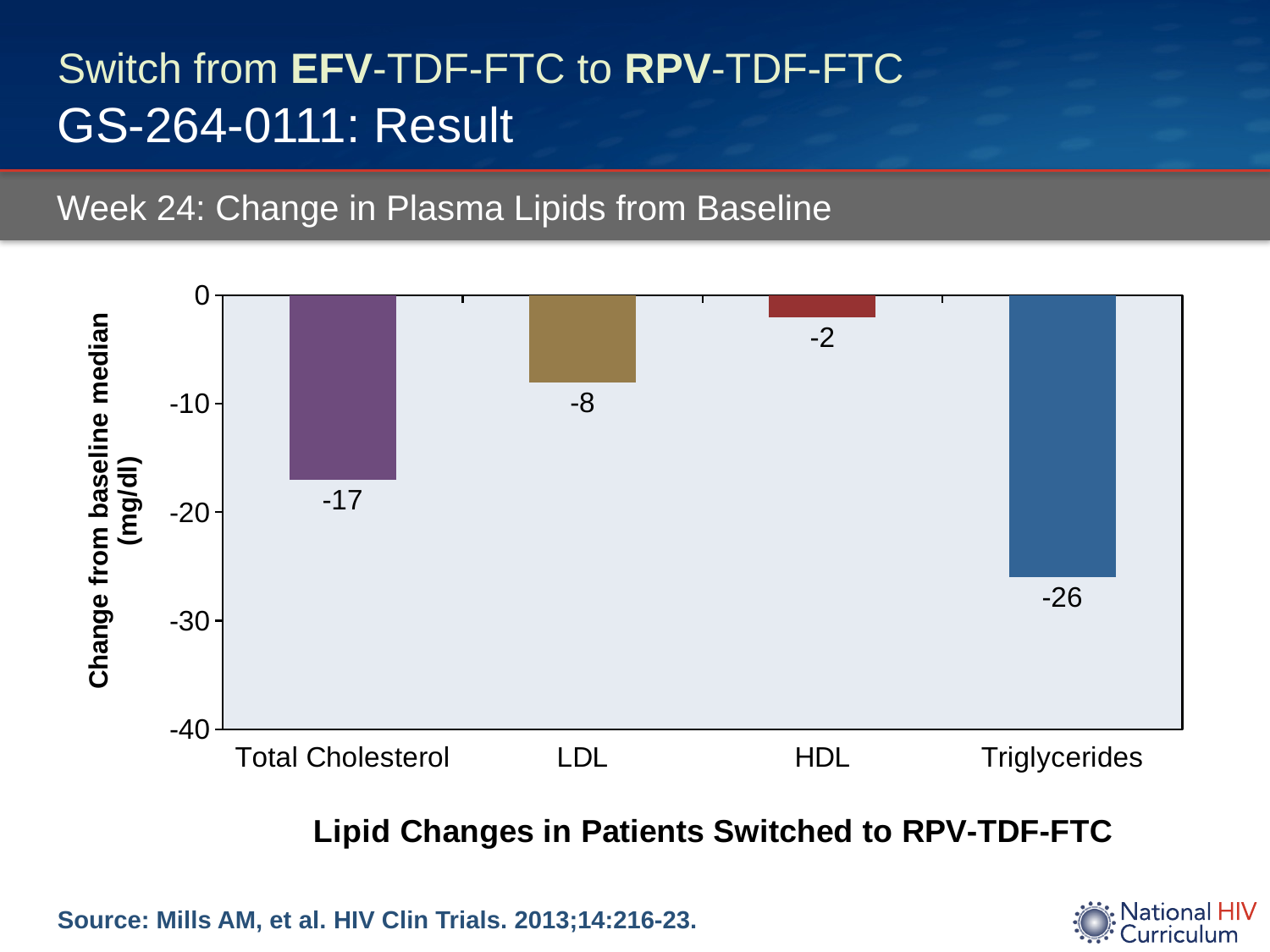
How many lipid categories are shown on the chart? 4 What kind of chart is shown on the slide? Bar chart What is the change from baseline median for LDL? -8 Which lipid category shows the largest decrease from baseline? Triglycerides What is the label of the vertical axis? Change from baseline median (mg/dl) Which lipid category shows the smallest decrease from baseline? HDL What is the change from baseline median for HDL? -2 What is the change from baseline median for Triglycerides? -26 What is the change from baseline median for Total Cholesterol? -17 What is the difference between the Triglycerides change and the Total Cholesterol change? 9 What is the title printed below the chart? Lipid Changes in Patients Switched to RPV-TDF-FTC Which has a larger decrease from baseline, LDL or Total Cholesterol? Total Cholesterol